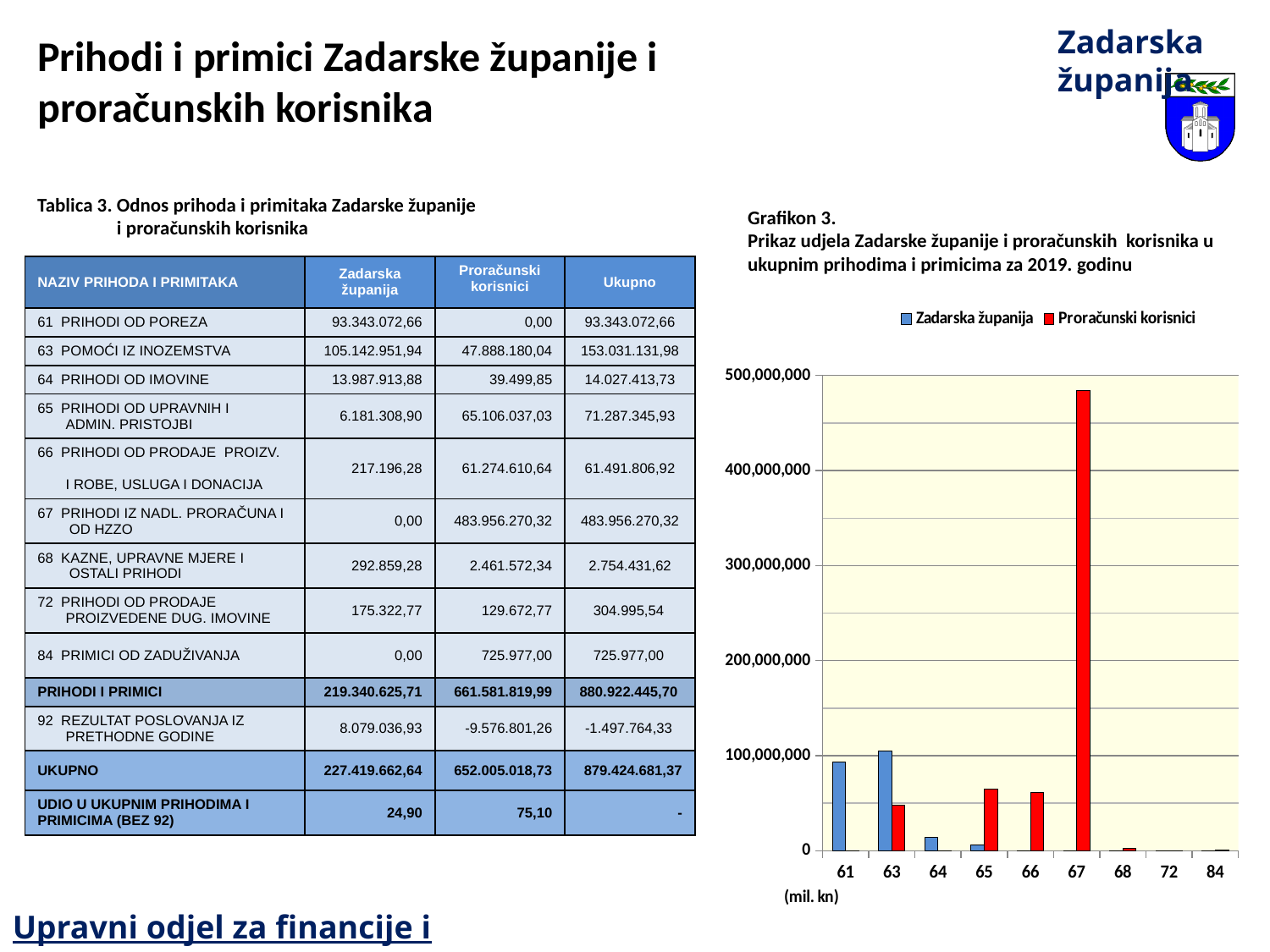
For category 65, which series has the larger bar, Zadarska županija or Proračunski korisnici? Proračunski korisnici Is the Proračunski korisnici value for category 67 greater or less than 500,000,000? less How many categories are shown on the x axis of the chart? 9 For which category is the Zadarska županija bar the highest? 63 Which series is shown in red in the chart? Proračunski korisnici Is the Proračunski korisnici value for category 65 greater or less than 100,000,000? less What unit is indicated below the x axis of the chart? (mil. kn) For category 63, which series has the larger bar, Zadarska županija or Proračunski korisnici? Zadarska županija Is the Proračunski korisnici value for category 67 greater or less than 400,000,000? greater What kind of chart is shown on the slide? bar chart How many series does the chart legend list? 2 Which category has the tallest bar in the chart? 67